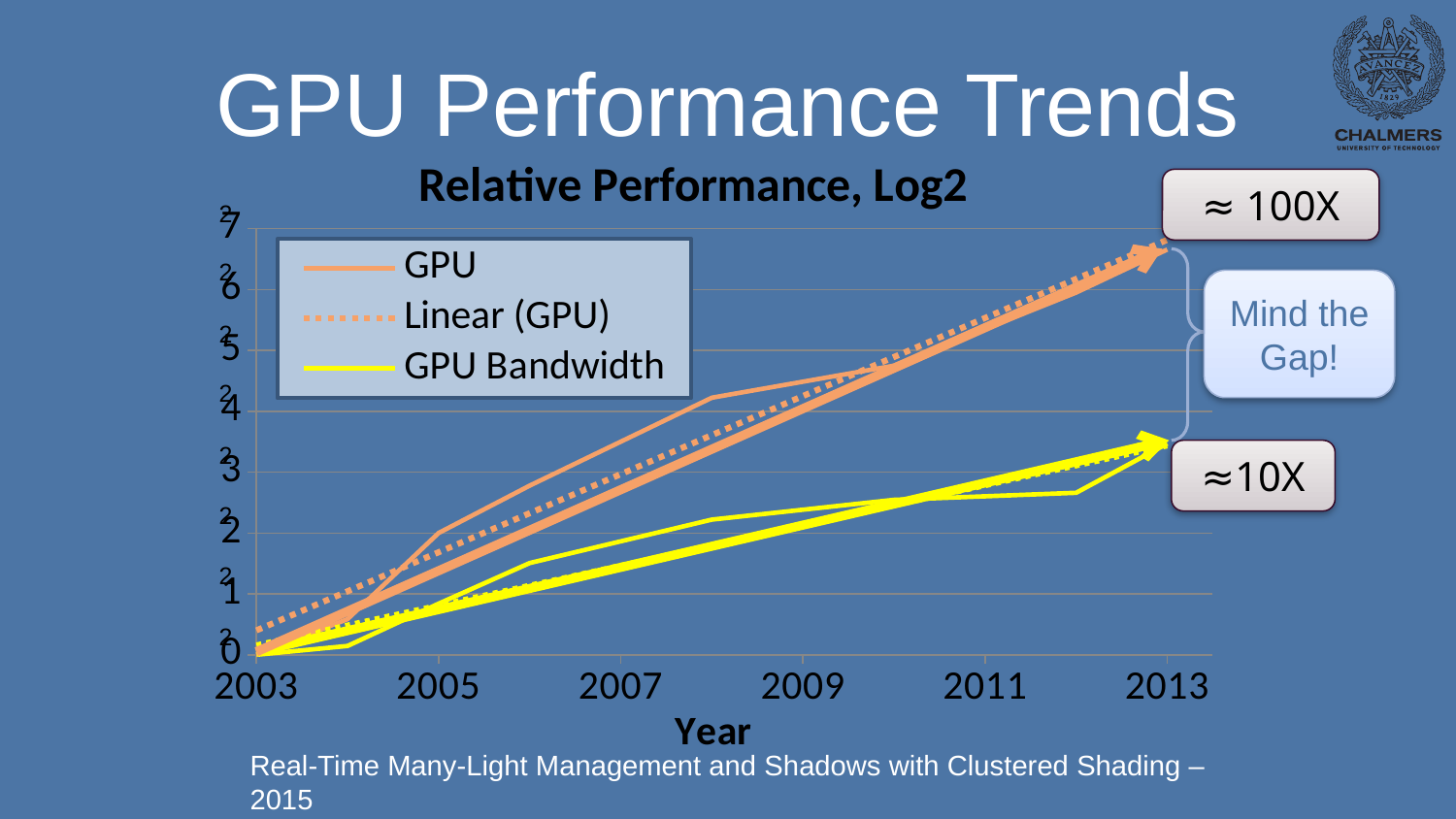
Is the value for GPU in 2013 greater or less than 6? greater What kind of chart is shown on the slide? line chart What is the label of the x axis? Year Does the GPU Bandwidth series rise or fall from 2003 to 2013? rise How many series does the chart legend list? 3 Is the value for GPU Bandwidth in 2013 greater or less than 4? less Which series reaches the highest value on the chart? GPU What is the title of the chart? Relative Performance, Log2 Does the GPU series rise or fall from 2003 to 2013? rise Which series has the higher value in 2013, GPU or GPU Bandwidth? GPU